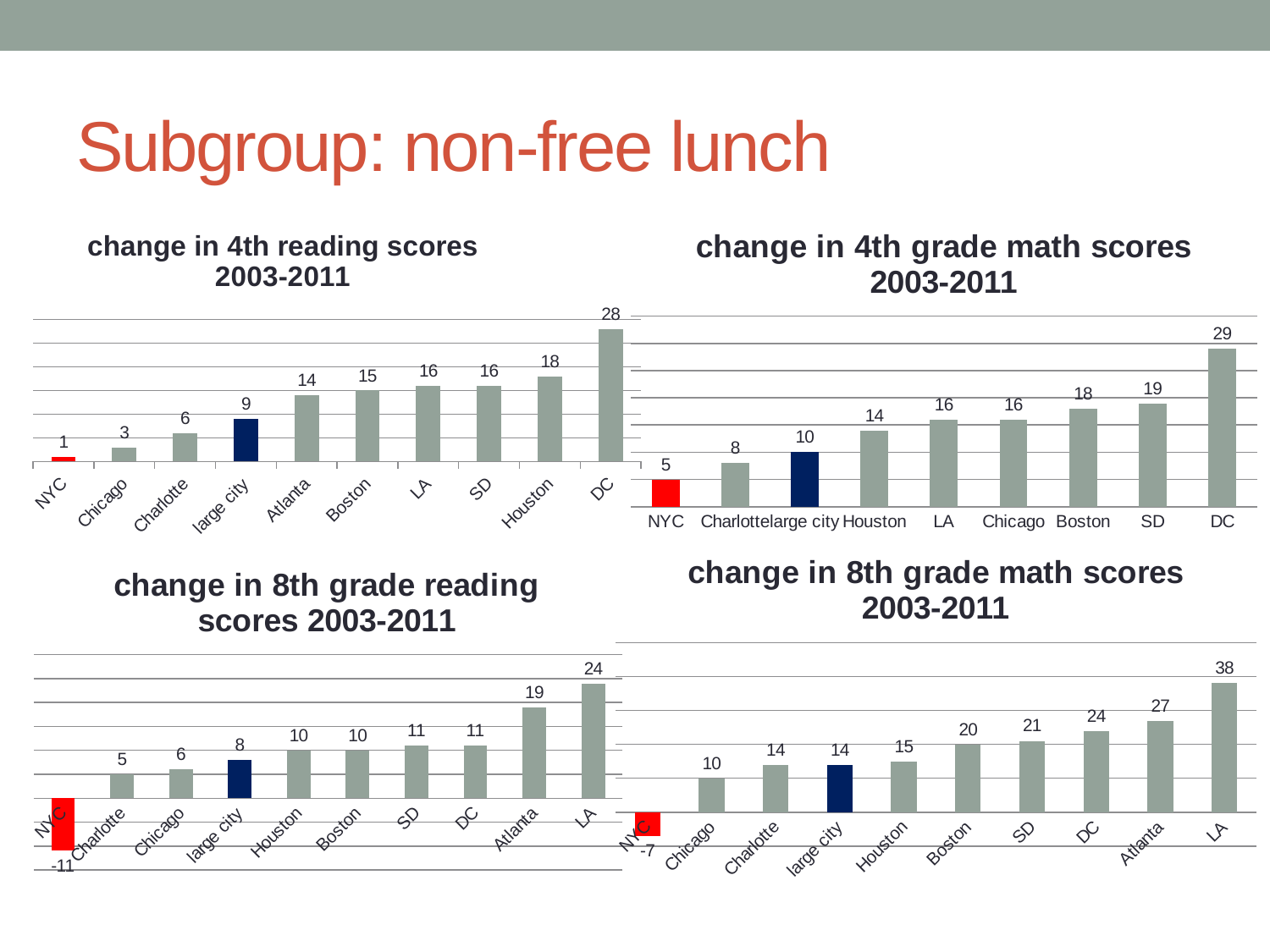
In the 'change in 4th grade math scores 2003-2011' chart, how many categories are shown? 9 In the 'change in 4th reading scores 2003-2011' chart, which city has the lowest value? NYC What type of chart is the 'change in 8th grade math scores 2003-2011' chart? bar chart In the 'change in 4th reading scores 2003-2011' chart, what is the value for DC? 28 In the 'change in 8th grade reading scores 2003-2011' chart, which city has the highest value? LA In the 'change in 4th grade math scores 2003-2011' chart, what is the difference between DC and NYC? 24 In the 'change in 8th grade reading scores 2003-2011' chart, what is the value for NYC? -11 In the 'change in 8th grade math scores 2003-2011' chart, what is the value for LA? 38 In the 'change in 4th grade math scores 2003-2011' chart, what is the value for large city? 10 In the 'change in 8th grade math scores 2003-2011' chart, what is the difference between Atlanta and Boston? 7 In the 'change in 4th reading scores 2003-2011' chart, how many categories are shown? 10 In the 'change in 8th grade reading scores 2003-2011' chart, which is larger, Atlanta or Houston? Atlanta